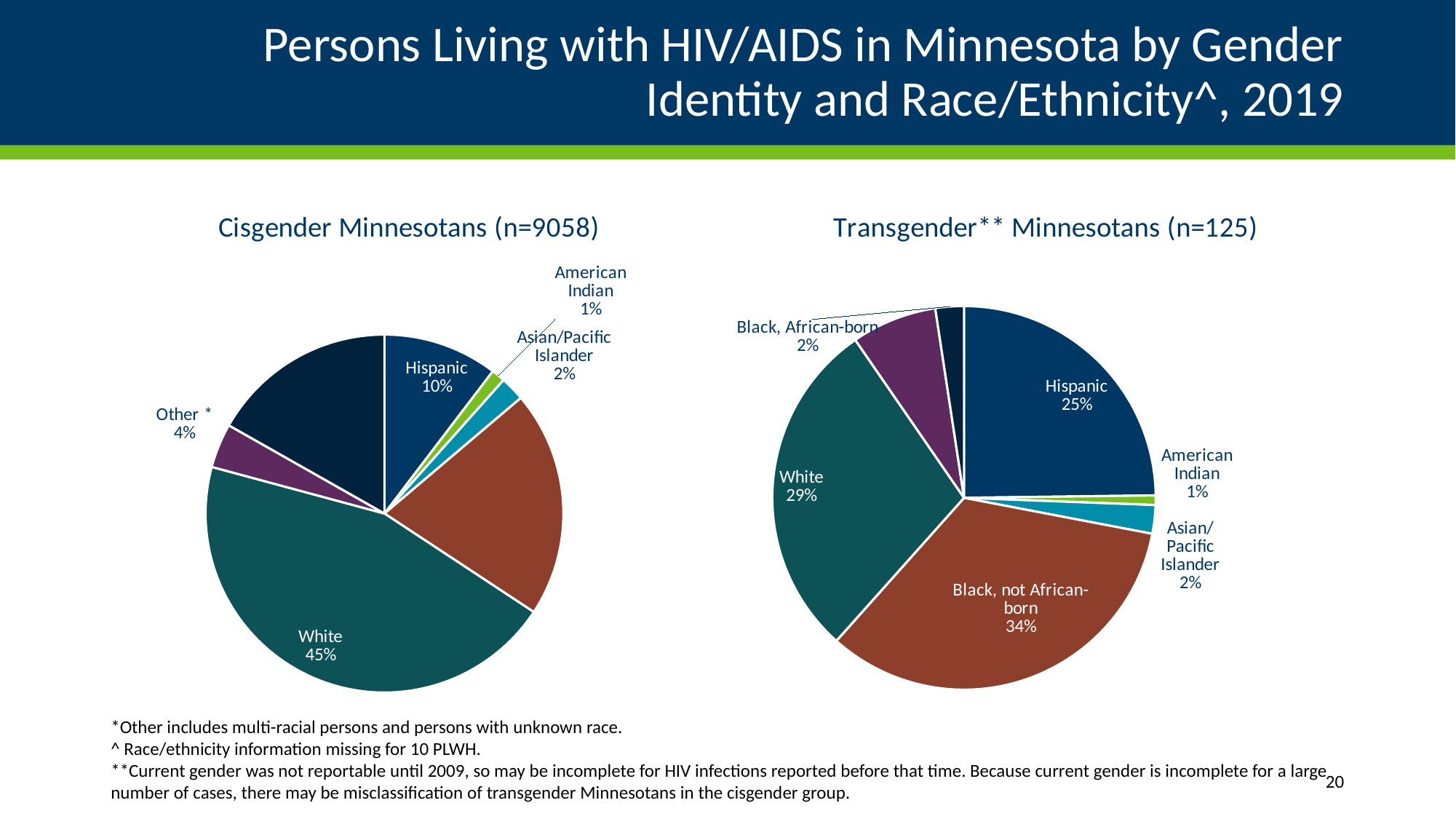
In the Transgender Minnesotans chart, what percentage is Black, African-born? 2% In the Cisgender Minnesotans chart, what percentage is Hispanic? 10% In the Cisgender Minnesotans chart, what percentage is labelled Other? 4% What is the difference between the Hispanic share in the Transgender Minnesotans chart and the Hispanic share in the Cisgender Minnesotans chart? 15% In the Cisgender Minnesotans chart, what share of persons living with HIV/AIDS are White? 45% In the Cisgender Minnesotans chart, which labelled group has the smallest share? American Indian In the Transgender Minnesotans chart, which labelled group has the largest share? Black, not African-born What type of chart is used on this slide? Pie chart In the Transgender Minnesotans chart, what percentage is Hispanic? 25% In the Transgender Minnesotans chart, what percentage is White? 29% Which is larger: the White share in the Cisgender Minnesotans chart or the White share in the Transgender Minnesotans chart? Cisgender Minnesotans In the Transgender Minnesotans chart, what share is Black, not African-born? 34%